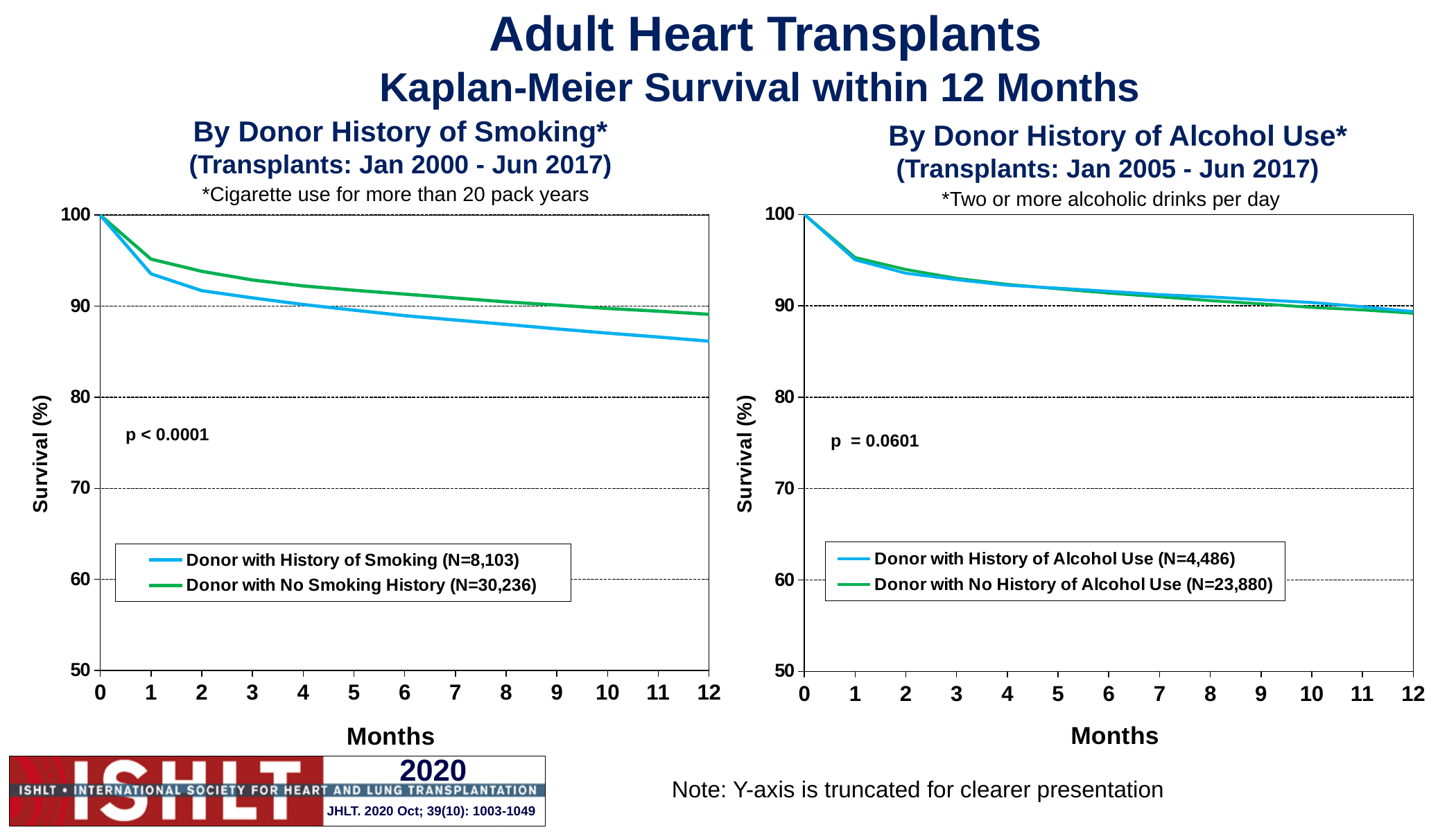
In the 'By Donor History of Smoking' chart, is the survival for Donor with No Smoking History at 6 months greater or less than 90? greater What is the N for Donor with History of Smoking in the legend of the left chart? 8,103 In the 'By Donor History of Smoking' chart, is the survival for Donor with History of Smoking at 6 months greater or less than 90? less In the 'By Donor History of Alcohol Use' chart, is the survival for Donor with History of Alcohol Use at 6 months greater or less than 90? greater In the 'By Donor History of Smoking' chart, do the survival curves rise or fall as months increase? Fall What p-value is shown on the 'By Donor History of Alcohol Use' chart? p = 0.0601 What type of chart is the 'By Donor History of Smoking' chart on the left? Line chart In the 'By Donor History of Smoking' chart, what is the survival (%) for both series at month 0? 100 In the 'By Donor History of Smoking' chart, which series has the higher survival at 12 months? Donor with No Smoking History (N=30,236) How many series does the legend of the 'By Donor History of Alcohol Use' chart list? 2 How many series does the legend of the 'By Donor History of Smoking' chart list? 2